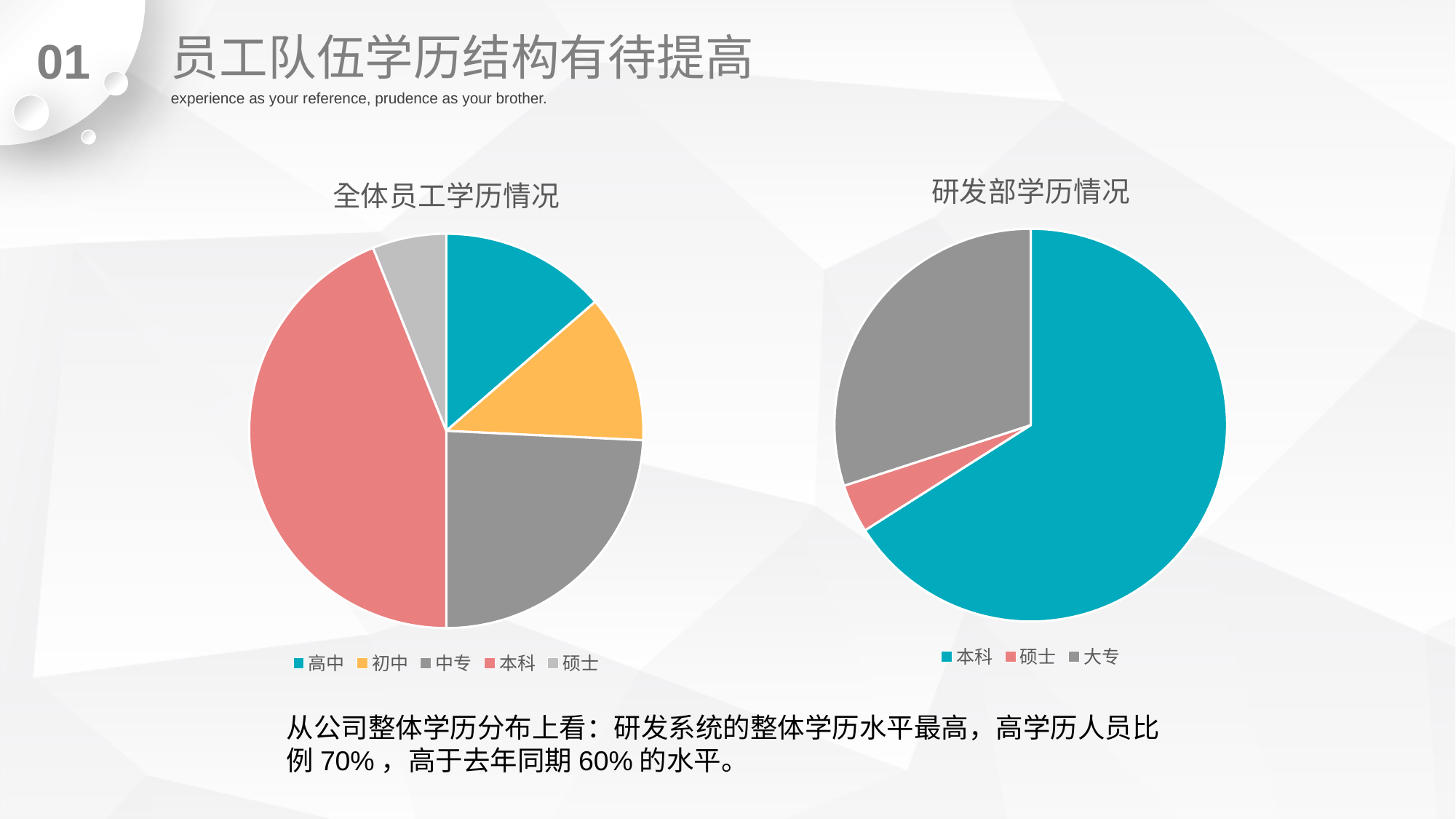
In the chart titled 研发部学历情况, which slice is larger, 大专 or 硕士? 大专 In the chart titled 研发部学历情况, which category has the largest slice? 本科 In the chart titled 研发部学历情况, how many slices does the pie have? 3 In the chart titled 全体员工学历情况, which category has the smallest slice? 硕士 In the chart titled 全体员工学历情况, how many categories does the legend list? 5 In the chart titled 全体员工学历情况, which category has the largest slice? 本科 What is the title of the pie chart on the right side of the slide? 研发部学历情况 In the chart titled 全体员工学历情况, which slice is larger, 中专 or 高中? 中专 What kind of chart is the chart titled 研发部学历情况? Pie chart What kind of chart is the chart titled 全体员工学历情况? Pie chart In the chart titled 全体员工学历情况, what colour is the 本科 slice? Red In the chart titled 研发部学历情况, which category has the smallest slice? 硕士